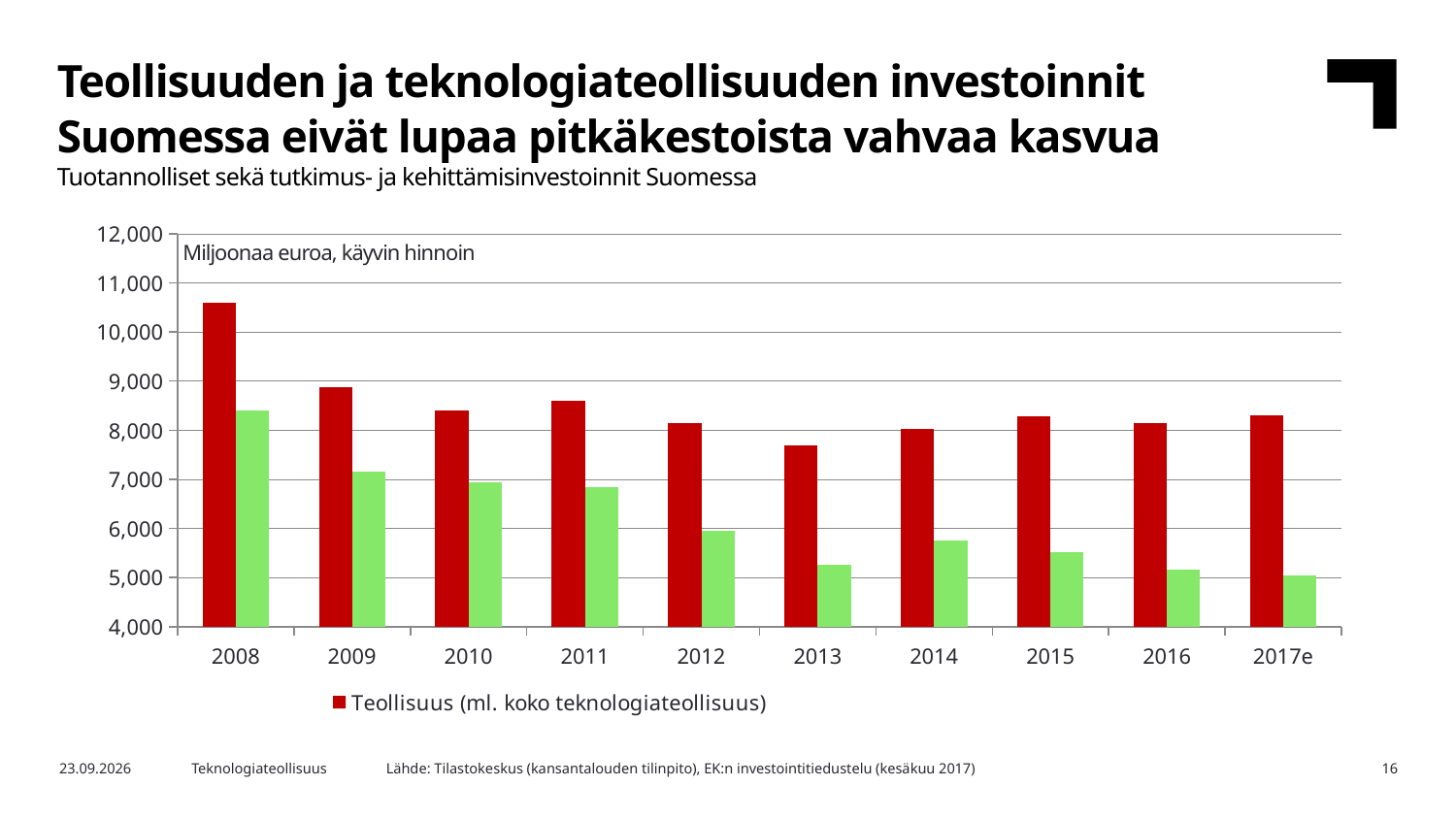
Which year has the highest value for Teollisuus (ml. koko teknologiateollisuus)? 2008 How many years (categories) are shown on the x axis? 10 What kind of chart is shown on the slide? bar chart What colour are the bars for Teollisuus (ml. koko teknologiateollisuus)? red What unit is stated in the label inside the chart area? Miljoonaa euroa, käyvin hinnoin Which is larger for Teollisuus (ml. koko teknologiateollisuus): the value in 2008 or in 2009? 2008 Is the value for Teollisuus (ml. koko teknologiateollisuus) in 2013 greater or less than 8,000? less Is the value for Teollisuus (ml. koko teknologiateollisuus) in 2008 greater or less than 10,000? greater How many series does the legend list? 1 Is the value for Teollisuus (ml. koko teknologiateollisuus) in 2011 greater or less than 8,000? greater Which year has the lowest value for Teollisuus (ml. koko teknologiateollisuus)? 2013 Does the value for Teollisuus (ml. koko teknologiateollisuus) overall rise or fall from 2008 to 2017e? fall